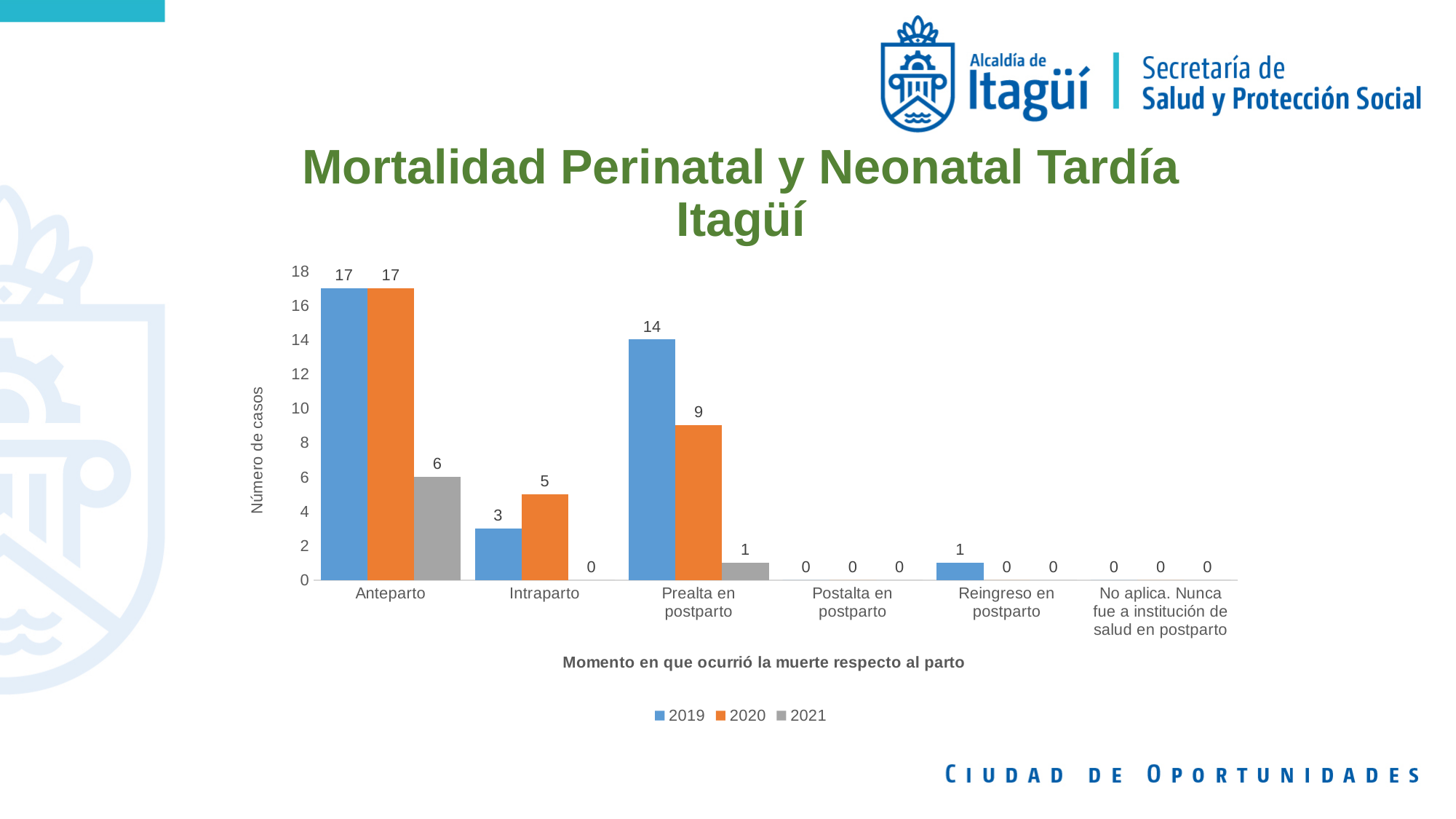
What is the label of the y axis? Número de casos Which is larger in the Intraparto category, the 2019 value or the 2020 value? 2020 Which category has the highest value for the 2021 series? Anteparto What is the difference between the 2019 and 2021 values in the Anteparto category? 11 What is the difference between the 2019 and 2020 values in the Prealta en postparto category? 5 What is the value for 2019 in the Reingreso en postparto category? 1 What is the value for 2020 in the Intraparto category? 5 How many categories are shown on the x axis? 6 How many series does the legend list? 3 What is the value for 2019 in the Anteparto category? 17 What is the value for 2021 in the Prealta en postparto category? 1 What kind of chart is shown on the slide? Bar chart